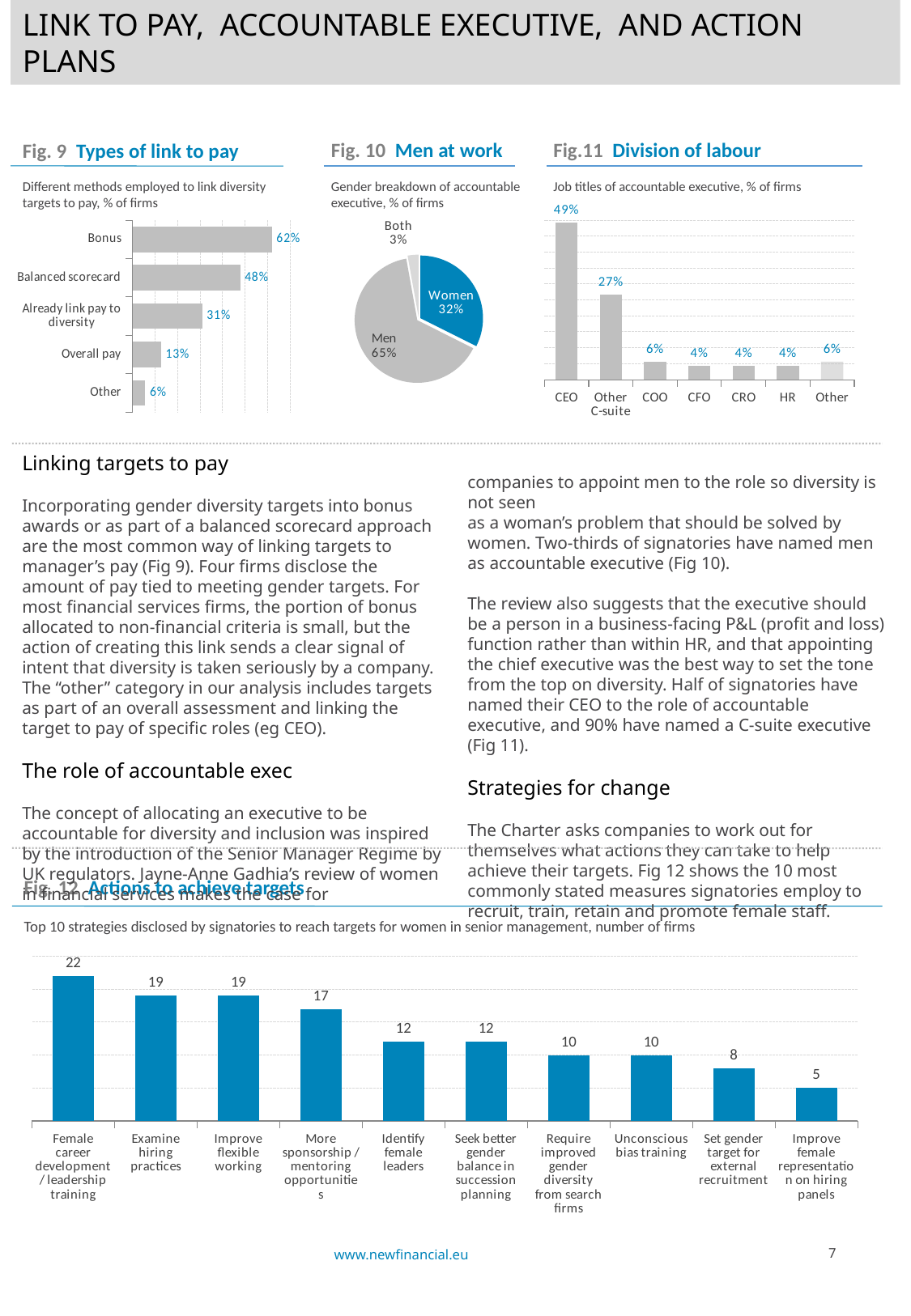
In the Fig. 12 'Actions to achieve targets' chart, which is larger: More sponsorship / mentoring opportunities or Identify female leaders? More sponsorship / mentoring opportunities In the Fig. 10 'Men at work' pie chart, how many slices are there? 3 In the Fig. 9 'Types of link to pay' chart, what is the difference between Balanced scorecard and Overall pay? 35% In the Fig.11 'Division of labour' chart, what is the value for Other C-suite? 27% In the Fig. 9 'Types of link to pay' chart, what is the value for Bonus? 62% In the Fig. 12 'Actions to achieve targets' chart, do the values rise or fall from left to right? Fall In the Fig. 9 'Types of link to pay' chart, which category has the lowest value? Other In the Fig.11 'Division of labour' chart, how many job title categories are shown? 7 What kind of chart is Fig. 10 'Men at work'? Pie chart In the Fig.11 'Division of labour' chart, which job title has the highest value? CEO In the Fig. 12 'Actions to achieve targets' chart, what is the value for Unconscious bias training? 10 In the Fig. 10 'Men at work' pie chart, what share is Women? 32%